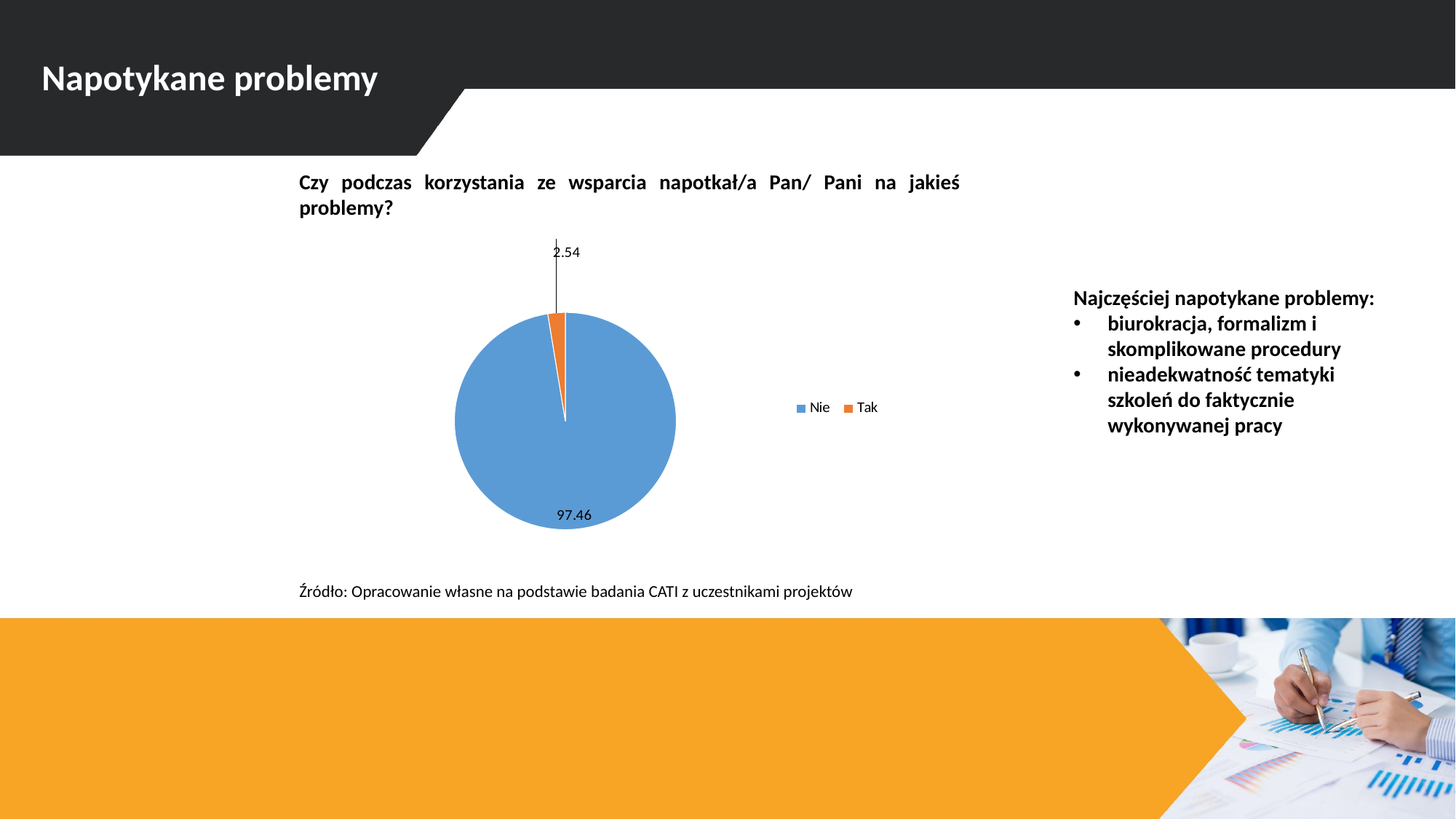
What colour is the "Nie" slice in the pie chart? blue How many categories does the pie chart show? 2 What is the value for "Nie" in the pie chart? 97.46 How many entries does the legend list? 2 Which is larger, the value for "Nie" or the value for "Tak"? Nie Which category has the largest slice in the pie chart? Nie What colour is the "Tak" slice in the pie chart? orange What kind of chart is shown on the slide? pie chart What is the value for "Tak" in the pie chart? 2.54 Which category has the smallest slice in the pie chart? Tak What is the difference between the values for "Nie" and "Tak"? 94.92